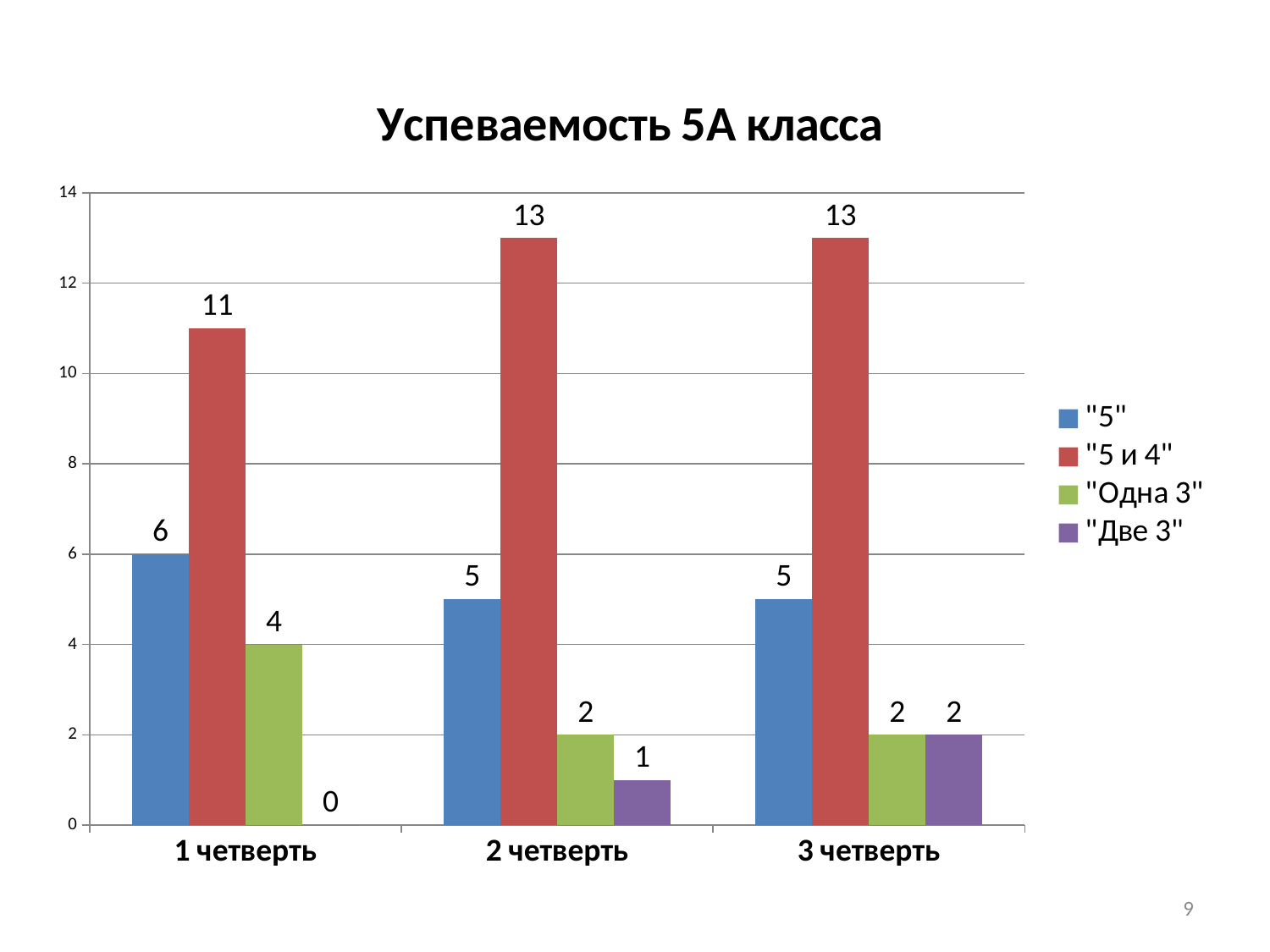
What is the value for "Одна 3" in 3 четверть? 2 How many series does the legend list? 4 What kind of chart is shown on the slide? Bar chart What is the difference between the "5 и 4" values in 2 четверть and 1 четверть? 2 In which quarter is the value for "Одна 3" highest? 1 четверть What is the value for "Две 3" in 1 четверть? 0 Which is larger: the value for "5" in 1 четверть or the value for "Одна 3" in 1 четверть? "5" in 1 четверть In which quarter is the value for "5" highest? 1 четверть What is the title of the chart? Успеваемость 5А класса How many categories (quarters) are shown on the x axis? 3 What is the value for "5 и 4" in 1 четверть? 11 What is the value for "5" in 2 четверть? 5